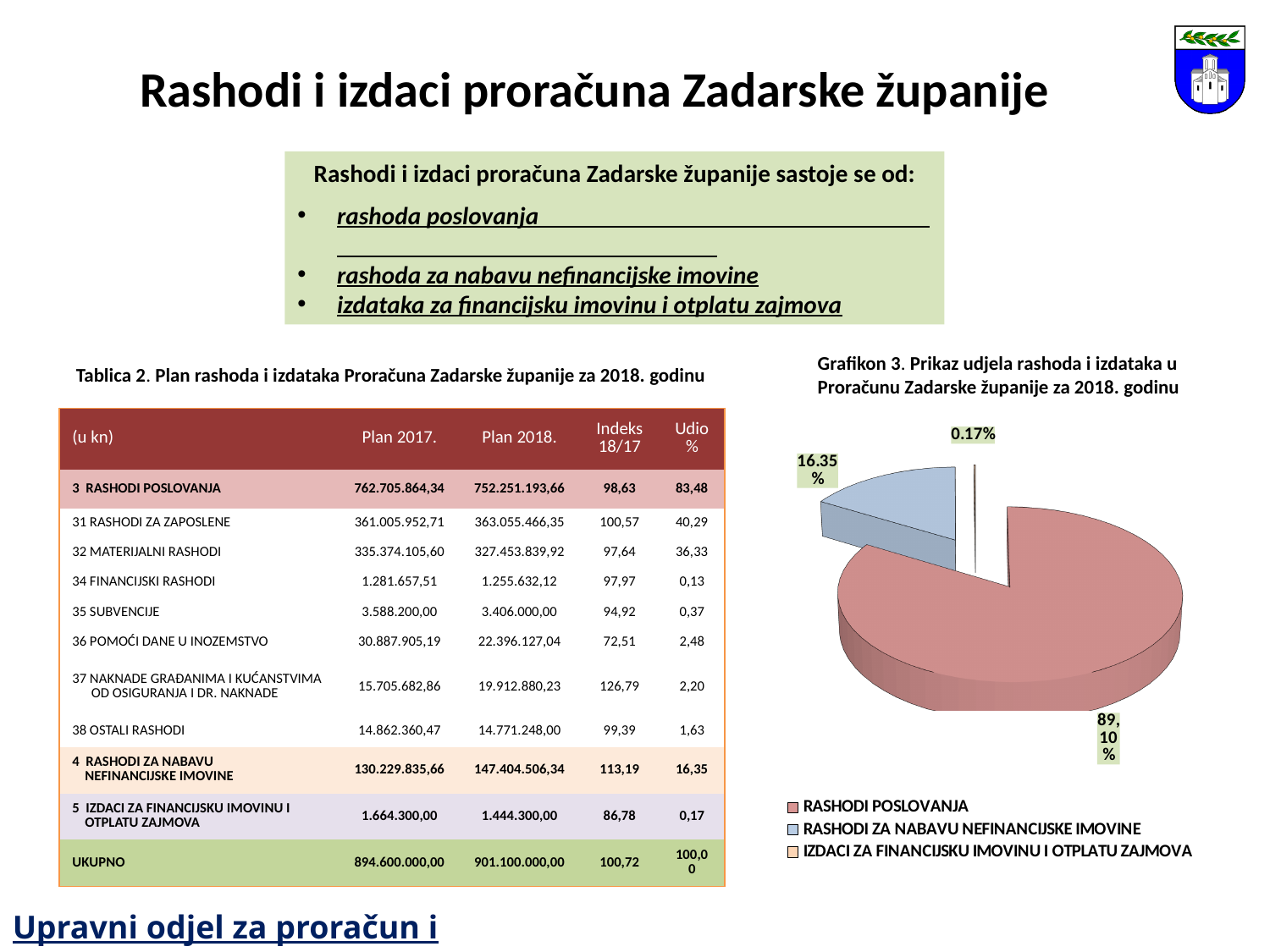
What is the title of the pie chart? Grafikon 3. Prikaz udjela rashoda i izdataka u Proračunu Zadarske županije za 2018. godinu What share does the IZDACI ZA FINANCIJSKU IMOVINU I OTPLATU ZAJMOVA slice show in the pie chart? 0.17% What share does the RASHODI ZA NABAVU NEFINANCIJSKE IMOVINE slice show in the pie chart? 16.35% What is the difference in percentage points between the RASHODI ZA NABAVU NEFINANCIJSKE IMOVINE slice and the IZDACI ZA FINANCIJSKU IMOVINU I OTPLATU ZAJMOVA slice? 16.18 How many entries does the legend of the pie chart list? 3 Which category has the largest slice in the pie chart? RASHODI POSLOVANJA Which slice is larger in the pie chart: RASHODI ZA NABAVU NEFINANCIJSKE IMOVINE or IZDACI ZA FINANCIJSKU IMOVINU I OTPLATU ZAJMOVA? RASHODI ZA NABAVU NEFINANCIJSKE IMOVINE Which category has the smallest slice in the pie chart? IZDACI ZA FINANCIJSKU IMOVINU I OTPLATU ZAJMOVA What kind of chart is shown on the slide? pie chart What share does the RASHODI POSLOVANJA slice show in the pie chart? 89,10% Which legend entry of the pie chart is shown in light blue? RASHODI ZA NABAVU NEFINANCIJSKE IMOVINE How many slices does the pie chart have? 3